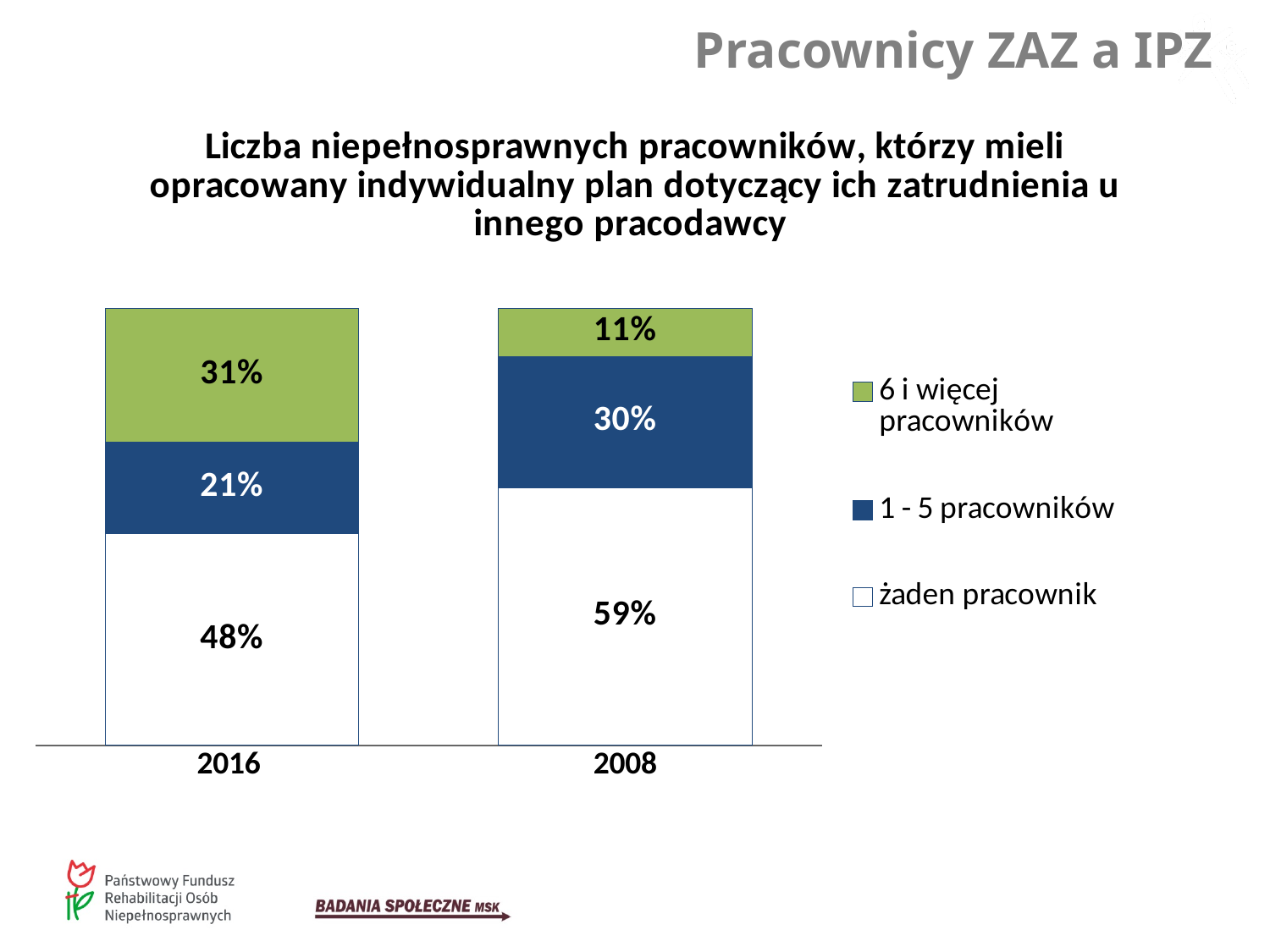
How many categories are shown on the x axis? 2 What is the value for "żaden pracownik" in 2008? 59% Which year has the higher value for "6 i więcej pracowników"? 2016 What is the value for "żaden pracownik" in 2016? 48% What is the value for "1 - 5 pracowników" in 2016? 21% What type of chart is shown on the slide? stacked bar chart Which colour represents "1 - 5 pracowników" in the legend? dark blue How many series does the legend list? 3 What is the difference between the "żaden pracownik" values for 2008 and 2016? 11% What is the difference between the "6 i więcej pracowników" values for 2016 and 2008? 20% What is the total of the stacked bar for 2016? 100% What is the value for "6 i więcej pracowników" in 2008? 11%